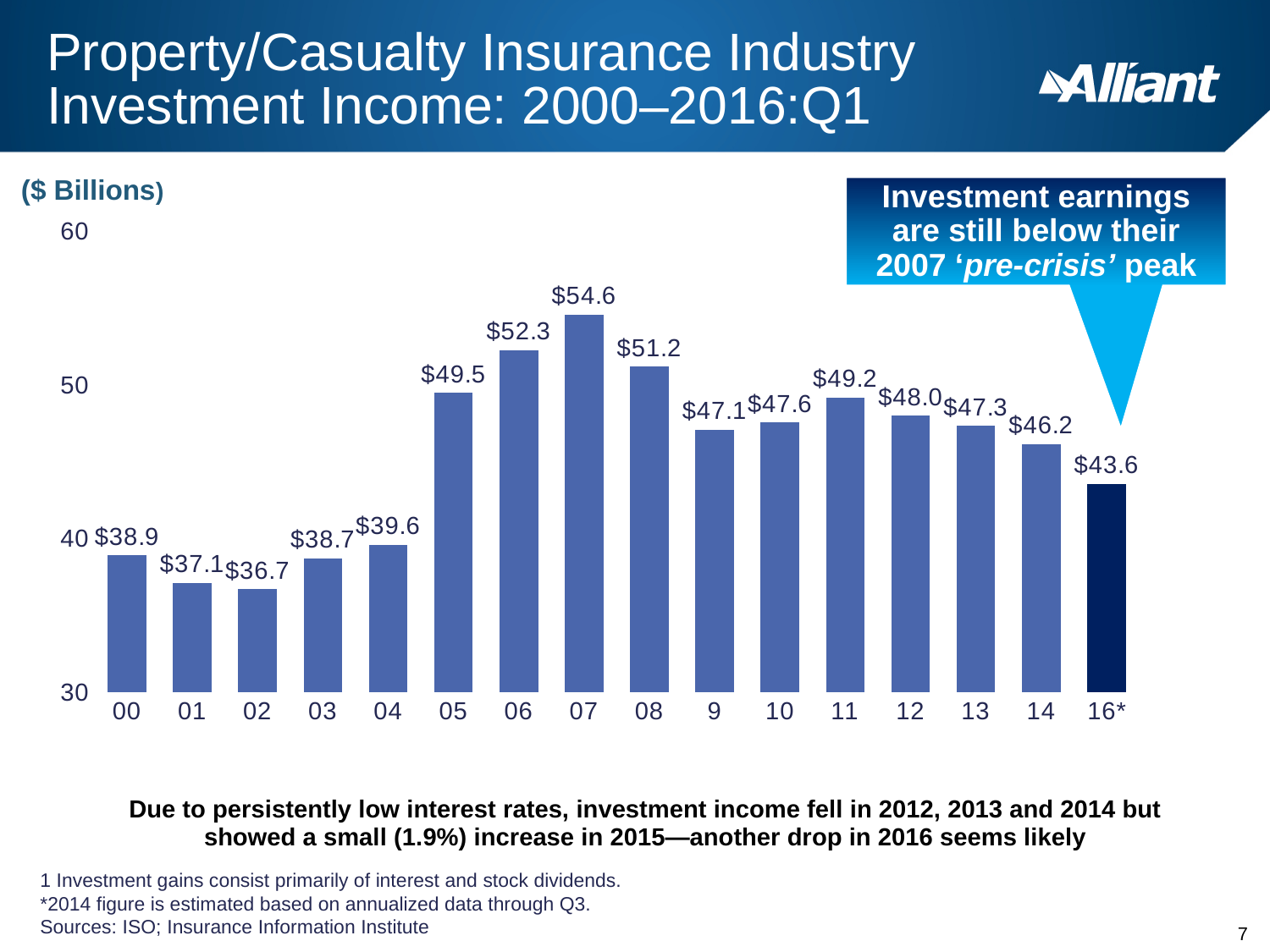
Is the value for 2004 greater or less than 40? less What kind of chart is shown on the slide? bar chart Which year has the lowest investment income? 02 Which is larger, the value for 2005 or the value for 2011? 2005 What is the investment income value for 16*? $43.6 What is the investment income value for 2000? $38.9 How many bars are shown in the chart? 16 What is the difference between the 2007 value and the 16* value? $11.0 Which year has the highest investment income? 07 What is the investment income value for 2007? $54.6 What unit is indicated for the values in the chart? $ Billions Do the values rise or fall from 2011 to 2014? fall